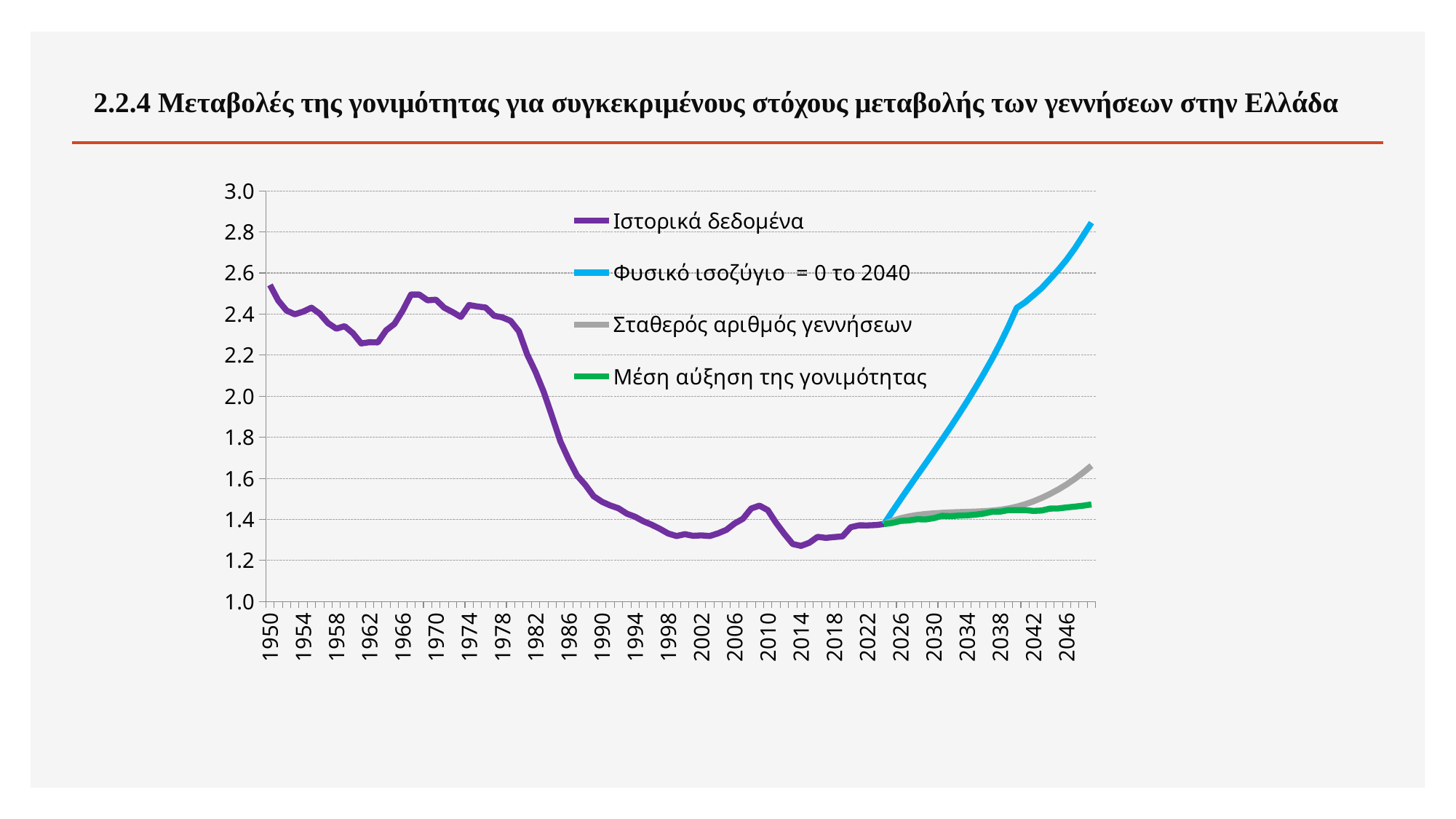
Is the value of Ιστορικά δεδομένα in 1986 greater or less than 2.0? less Is the value of Ιστορικά δεδομένα in 1950 greater or less than 2.4? greater Which series does the legend list first? Ιστορικά δεδομένα In 2046, which is higher: Φυσικό ισοζύγιο = 0 το 2040 or Σταθερός αριθμός γεννήσεων? Φυσικό ισοζύγιο = 0 το 2040 Is the value of Μέση αύξηση της γονιμότητας in 2046 greater or less than 1.6? less Which series reaches the highest value at the right end of the chart? Φυσικό ισοζύγιο = 0 το 2040 What colour is the line for Φυσικό ισοζύγιο = 0 το 2040? light blue Does the Ιστορικά δεδομένα line rise or fall between 1980 and 1990? fall What kind of chart is shown on the slide? line chart How many series does the legend list? 4